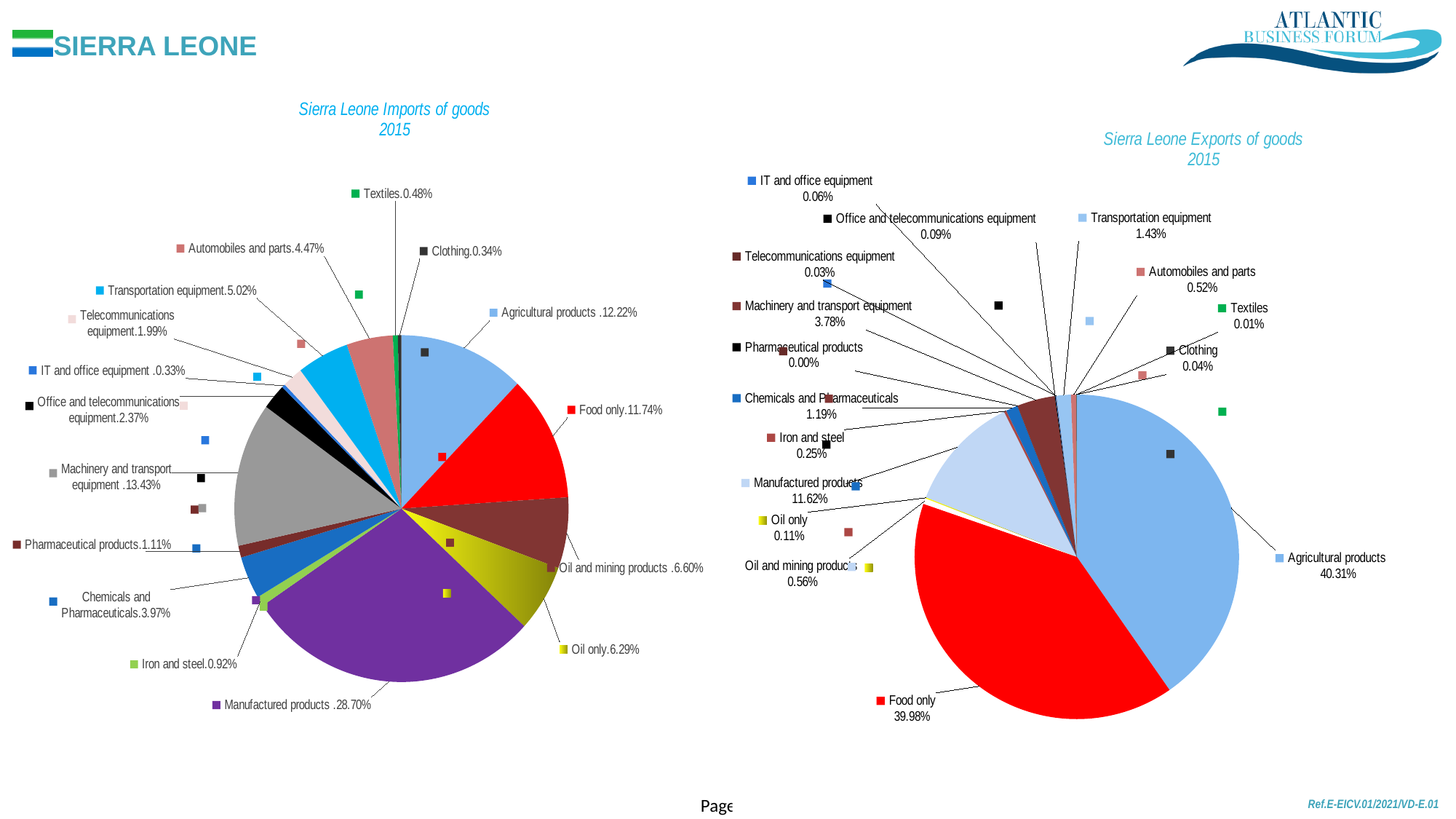
In the Sierra Leone Imports of goods 2015 chart, what is the difference between the shares of Agricultural products and Food only? 0.48% In the Sierra Leone Imports of goods 2015 chart, which category has the largest share? Manufactured products In the Sierra Leone Exports of goods 2015 chart, which is larger: Manufactured products or Machinery and transport equipment? Manufactured products In the Sierra Leone Imports of goods 2015 chart, what is the difference between the shares of Oil and mining products and Oil only? 0.31% In the Sierra Leone Exports of goods 2015 chart, what share do Agricultural products have? 40.31% What kind of chart is the Sierra Leone Imports of goods 2015 chart? Pie chart In the Sierra Leone Exports of goods 2015 chart, what share does Food only have? 39.98% What is the title of the chart on the right side of the slide? Sierra Leone Exports of goods 2015 In the Sierra Leone Imports of goods 2015 chart, what share do Manufactured products have? 28.70% In the Sierra Leone Exports of goods 2015 chart, which category has the smallest share? Pharmaceutical products In the Sierra Leone Imports of goods 2015 chart, what share does Transportation equipment have? 5.02% How many categories are shown in the Sierra Leone Exports of goods 2015 chart? 16